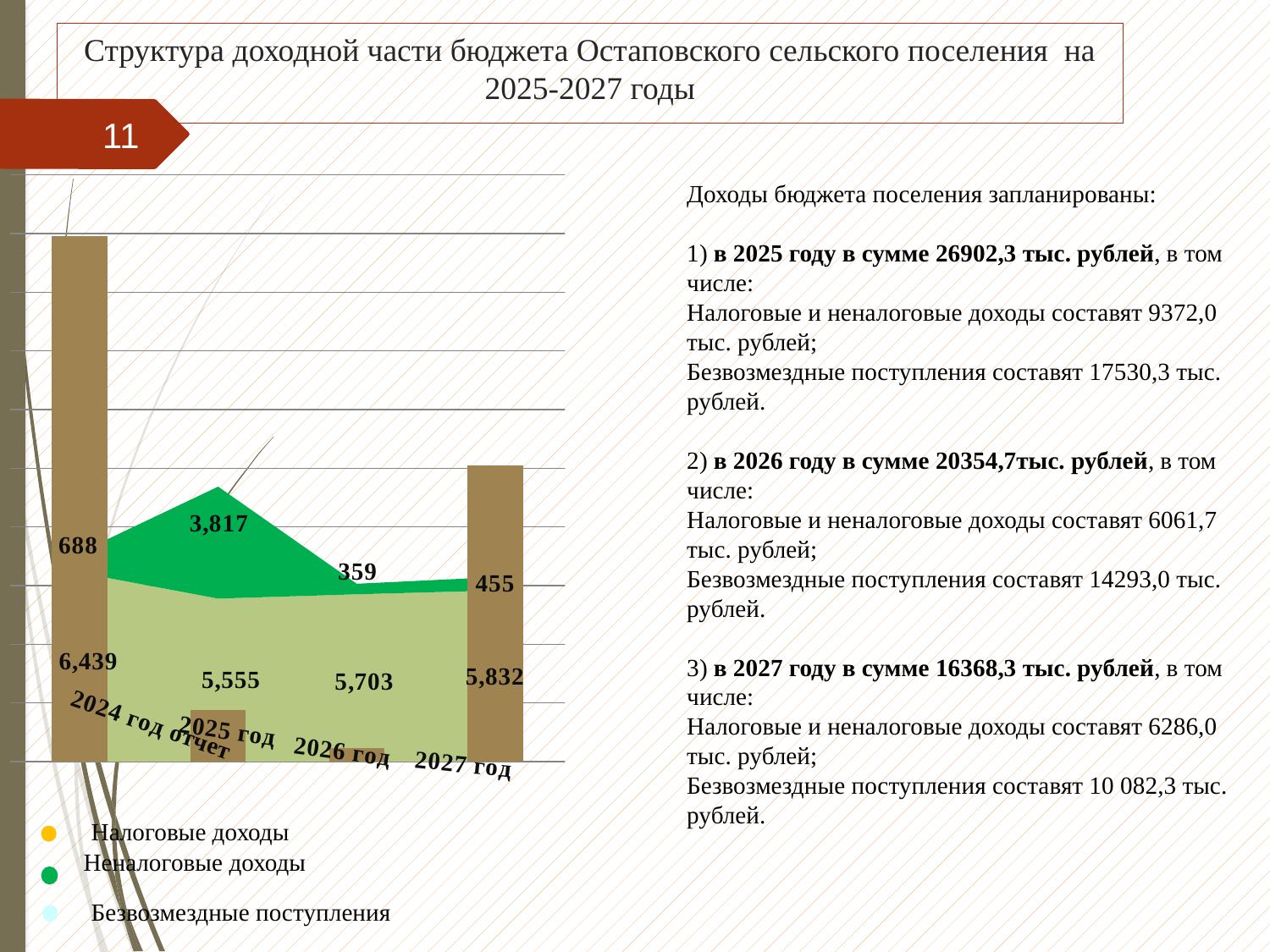
What is the value of неналоговые доходы for 2027 год? 455 What is the value of налоговые доходы for 2025 год? 5,555 Which is larger: неналоговые доходы in 2024 год отчет or in 2027 год? 2024 год отчет What is the difference between налоговые доходы in 2027 год and 2026 год? 129 What is the value of неналоговые доходы for 2026 год? 359 In which year are налоговые доходы highest? 2024 год отчет In which year is the bar for безвозмездные поступления tallest? 2024 год отчет In which year are неналоговые доходы highest? 2025 год How many year categories are shown on the x axis? 4 What is the value of налоговые доходы for 2024 год отчет? 6,439 How many series does the legend list? 3 In which year are неналоговые доходы lowest? 2026 год